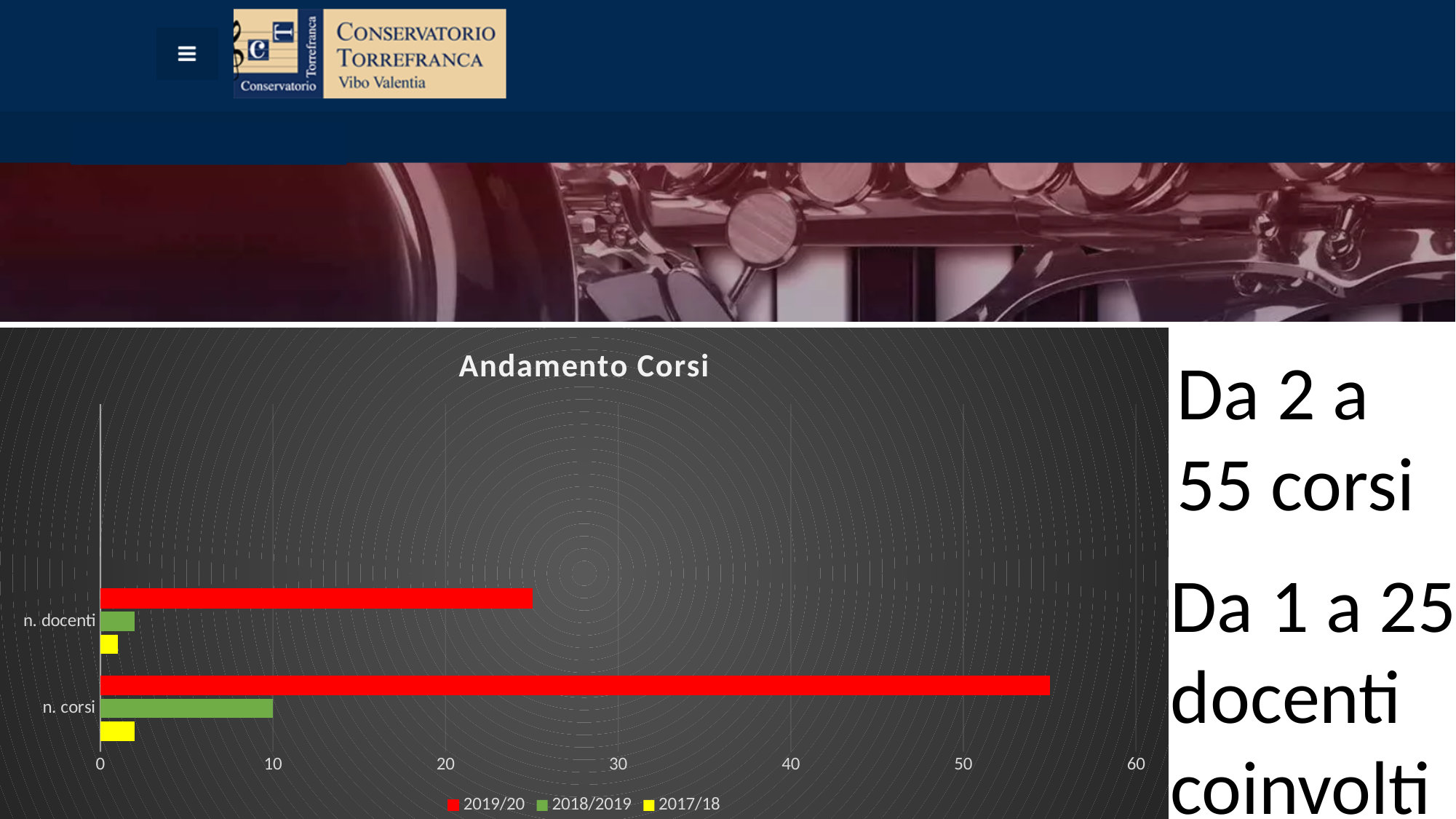
Is the value for n. corsi in the 2019/20 series greater or less than 50? greater Which series has the lowest value for n. docenti? 2017/18 Is the value for n. docenti in the 2019/20 series greater or less than 30? less What is the title of the chart? Andamento Corsi Is the value for n. docenti in the 2019/20 series greater or less than 20? greater Which is larger: the 2019/20 value for n. corsi or the 2019/20 value for n. docenti? n. corsi What is the value for n. corsi in the 2018/2019 series? 10 How many series does the chart legend list? 3 Which series has the highest value for n. corsi? 2019/20 What kind of chart is shown on the slide? bar chart Which series is shown in red in the chart? 2019/20 How many categories are shown on the chart's vertical axis? 2